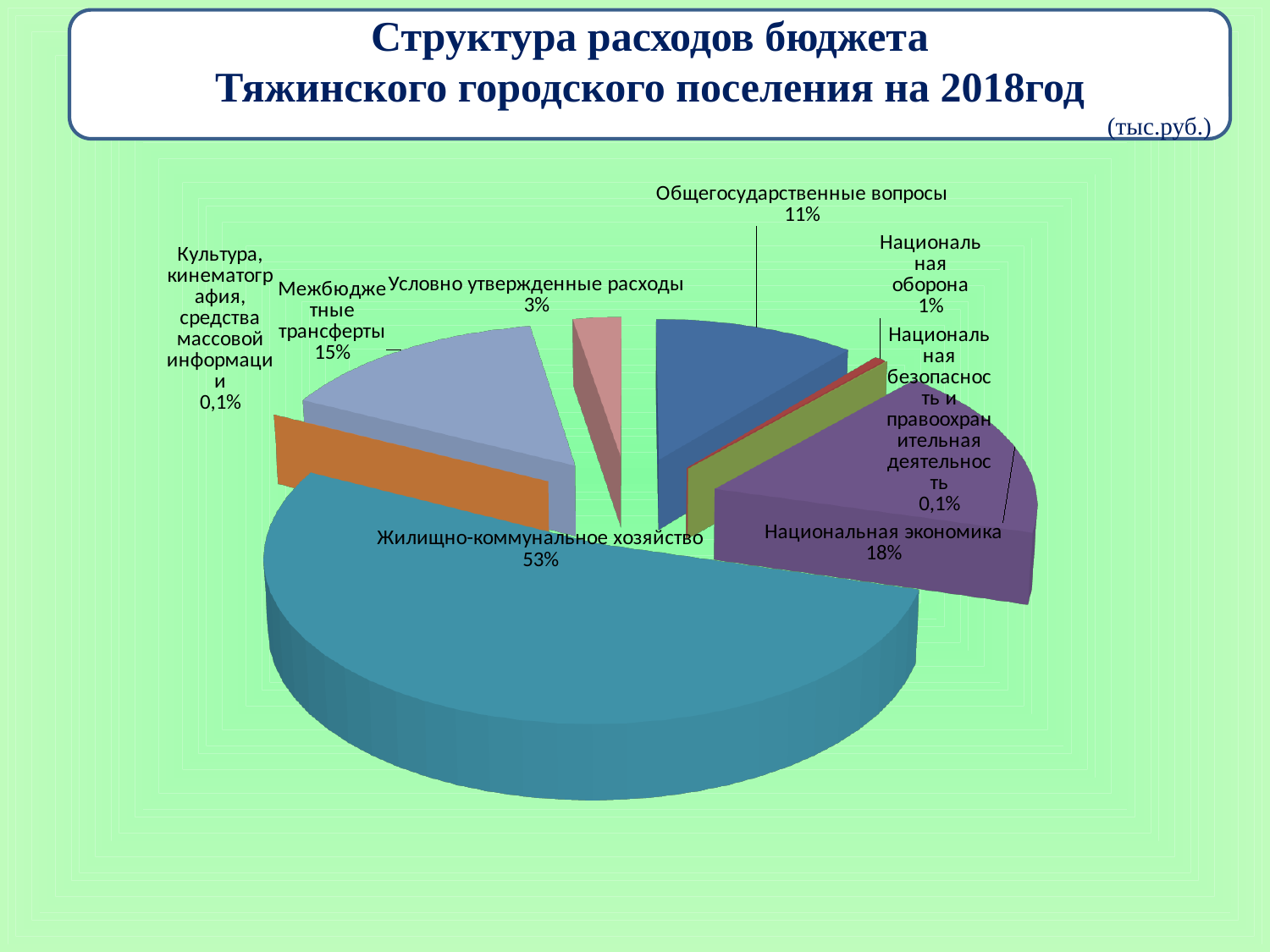
What share of the budget expenditure goes to Национальная оборона? 1% What share of the budget expenditure goes to Общегосударственные вопросы? 11% Which has a larger share: Национальная экономика or Межбюджетные трансферты? Национальная экономика Which expenditure category has the largest share of the pie? Жилищно-коммунальное хозяйство What unit is indicated in the top right corner of the slide title box? тыс.руб. What share of the budget expenditure goes to Национальная экономика? 18% What is the difference in percentage points between the shares of Жилищно-коммунальное хозяйство and Национальная экономика? 35 How many expenditure categories are shown in the pie chart? 8 What kind of chart is shown on the slide? pie chart